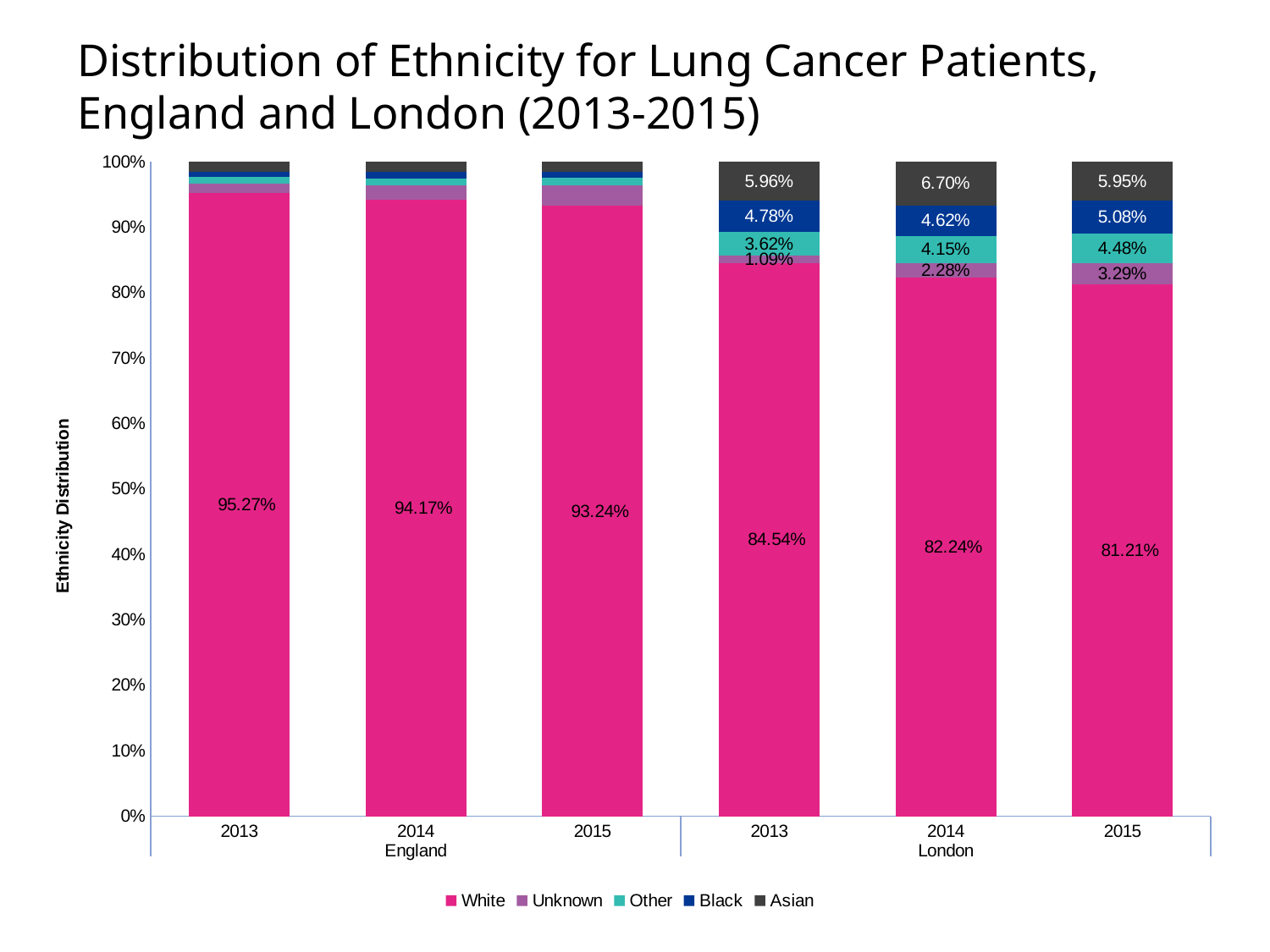
Which bar has the highest White share? England 2013 What is the Asian share for London in 2014? 6.70% What is the White share for England in 2013? 95.27% Which bar has the lowest White share? London 2015 What is the Unknown share for London in 2015? 3.29% What is the difference between the White share for England in 2013 and London in 2013? 10.73% What kind of chart is shown on the slide? Stacked bar chart Is the White share for England in 2015 greater or less than 90%? greater Which is larger, the Other share for London in 2014 or the Other share for London in 2015? London 2015 How many series does the legend list? 5 Does the White share for London rise or fall from 2013 to 2015? Fall What is the Black share for London in 2013? 4.78%